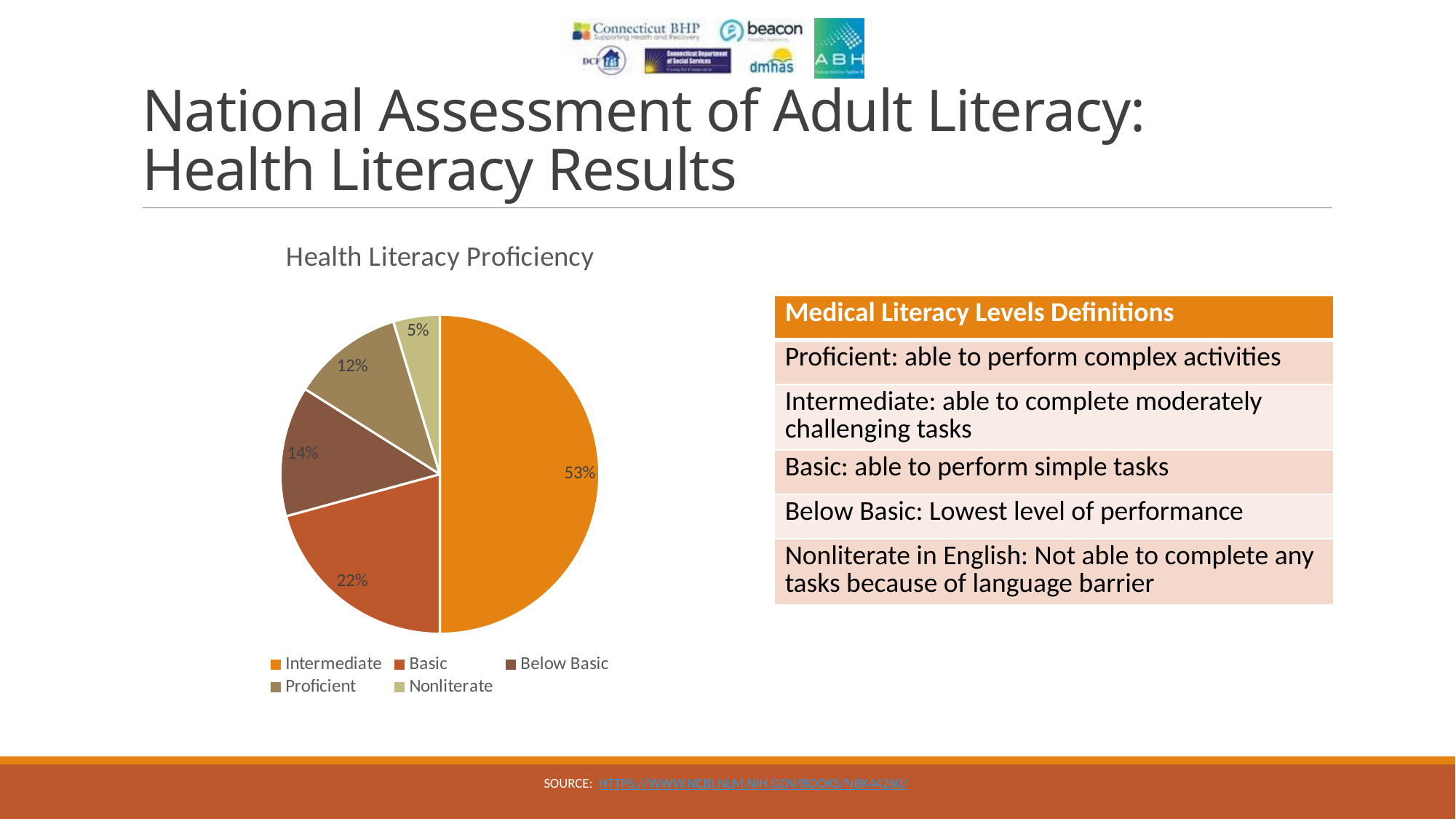
What is the difference in percentage points between Intermediate and Basic in the Health Literacy Proficiency chart? 31 Which category has the largest slice in the Health Literacy Proficiency chart? Intermediate Which is larger in the Health Literacy Proficiency chart, Below Basic or Proficient? Below Basic What percentage is shown for Basic in the Health Literacy Proficiency chart? 22% What share of the pie does Intermediate represent in the Health Literacy Proficiency chart? 53% What is the title of the chart on the slide? Health Literacy Proficiency How many categories are shown in the Health Literacy Proficiency chart? 5 Which category has the smallest slice in the Health Literacy Proficiency chart? Nonliterate What percentage is shown for Below Basic in the Health Literacy Proficiency chart? 14% What percentage is shown for Nonliterate in the Health Literacy Proficiency chart? 5% What type of chart is the Health Literacy Proficiency chart? Pie chart What percentage is shown for Proficient in the Health Literacy Proficiency chart? 12%